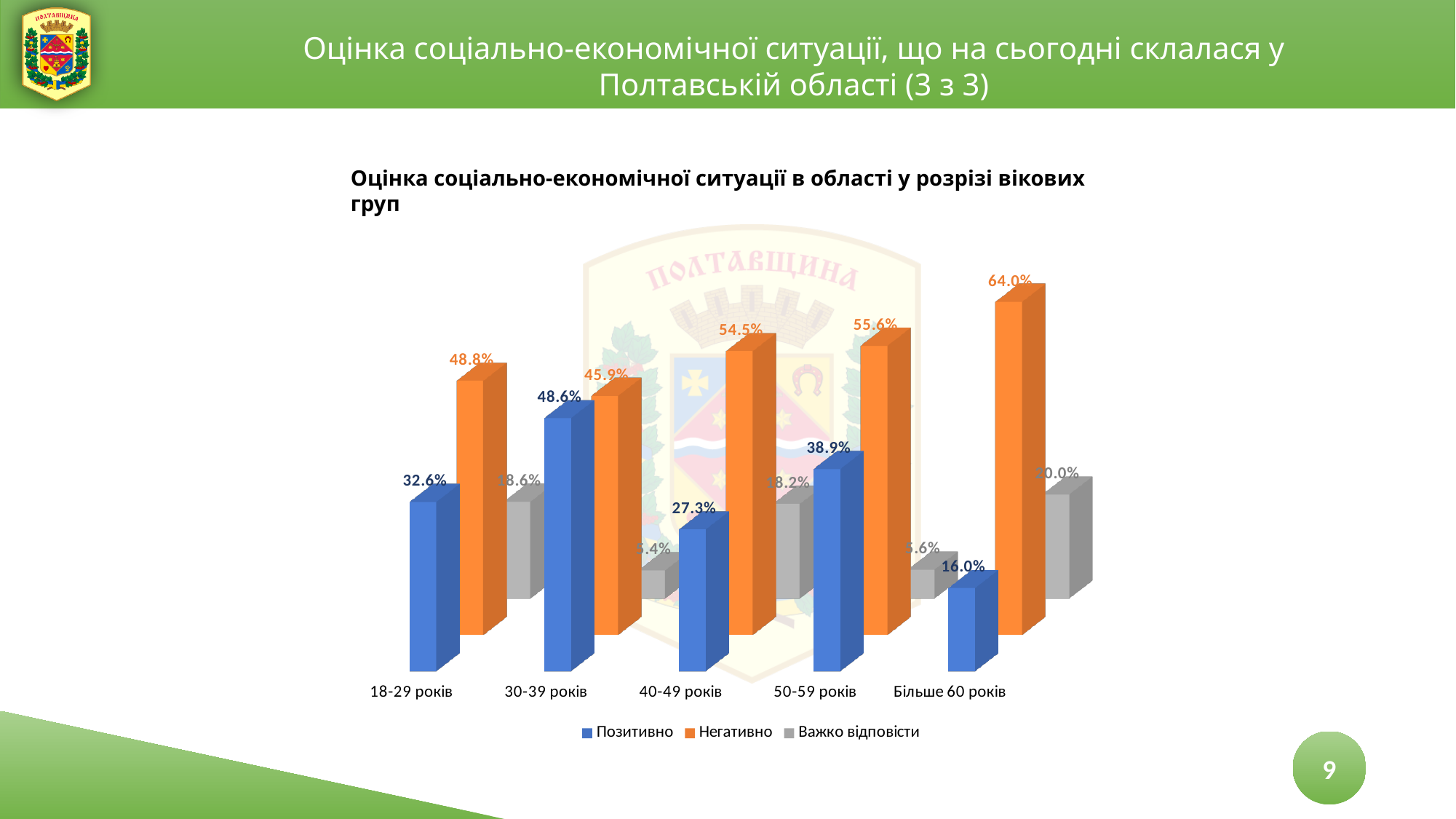
Which age group has the highest Негативно value? Більше 60 років What is the value for Негативно in the Більше 60 років age group? 64.0% Which age group has the lowest Позитивно value? Більше 60 років What is the value for Важко відповісти in the Більше 60 років age group? 20.0% How many series does the legend list? 3 What is the value for Позитивно in the 30-39 років age group? 48.6% How many age groups are shown on the x axis? 5 Which colour represents the Негативно series? Orange What kind of chart is shown on the slide? Bar chart What is the value for Позитивно in the 40-49 років age group? 27.3% What is the difference between the Негативно and Позитивно values for the 18-29 років age group? 16.2% In the 30-39 років age group, which is larger: Позитивно or Негативно? Позитивно